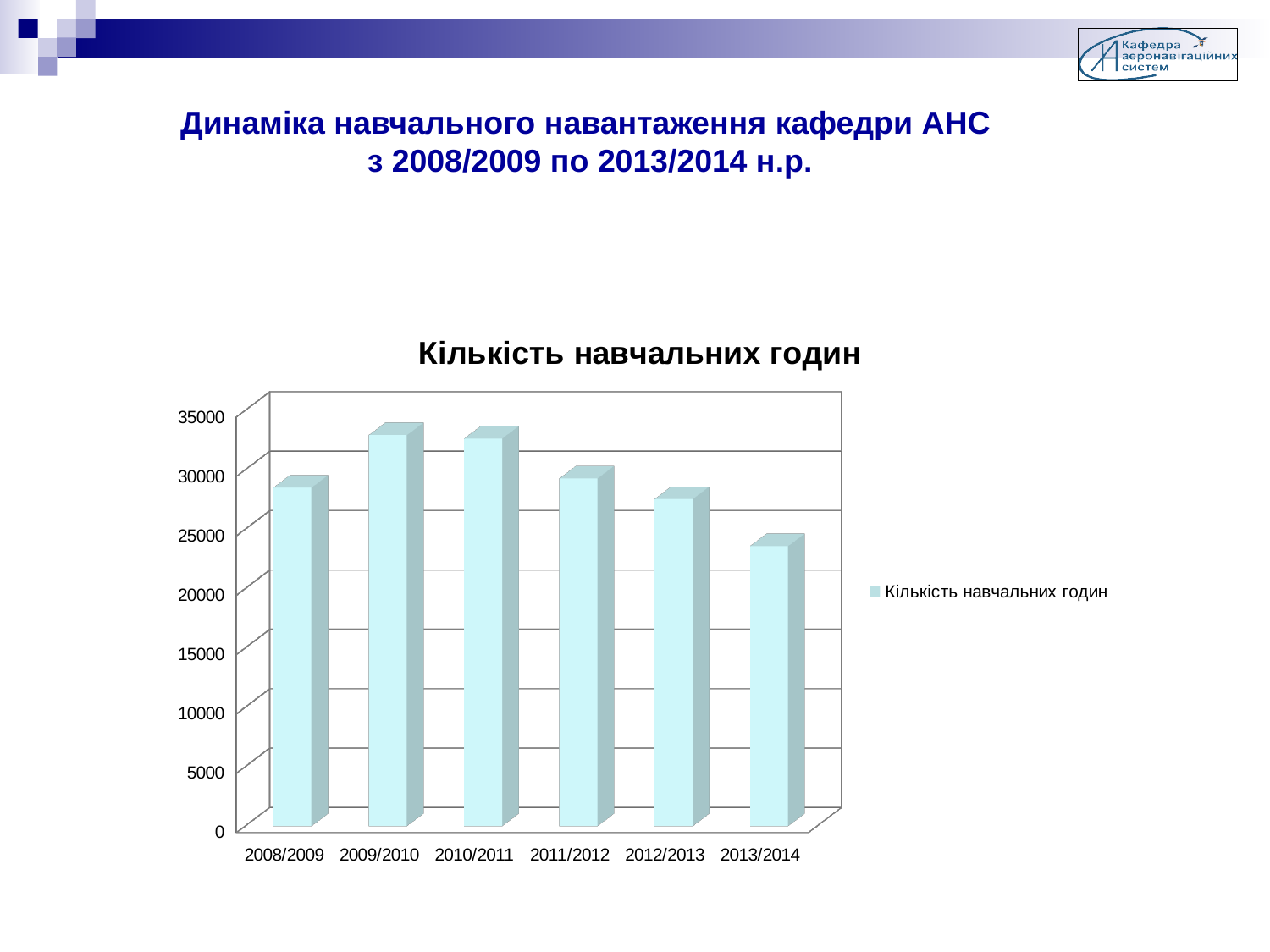
Is the value for 2008/2009 greater or less than 25000? greater Which is larger, the value for 2009/2010 or the value for 2013/2014? 2009/2010 How many series does the chart legend list? 1 What kind of chart is shown on the slide? bar chart Which is larger, the value for 2010/2011 or the value for 2011/2012? 2010/2011 What is the title of the chart? Кількість навчальних годин How many academic years are shown on the x axis of the chart? 6 Do the values rise or fall from 2009/2010 to 2013/2014? fall Is the value for 2009/2010 greater or less than 30000? greater Is the value for 2013/2014 greater or less than 25000? less Which academic year has the lowest number of teaching hours? 2013/2014